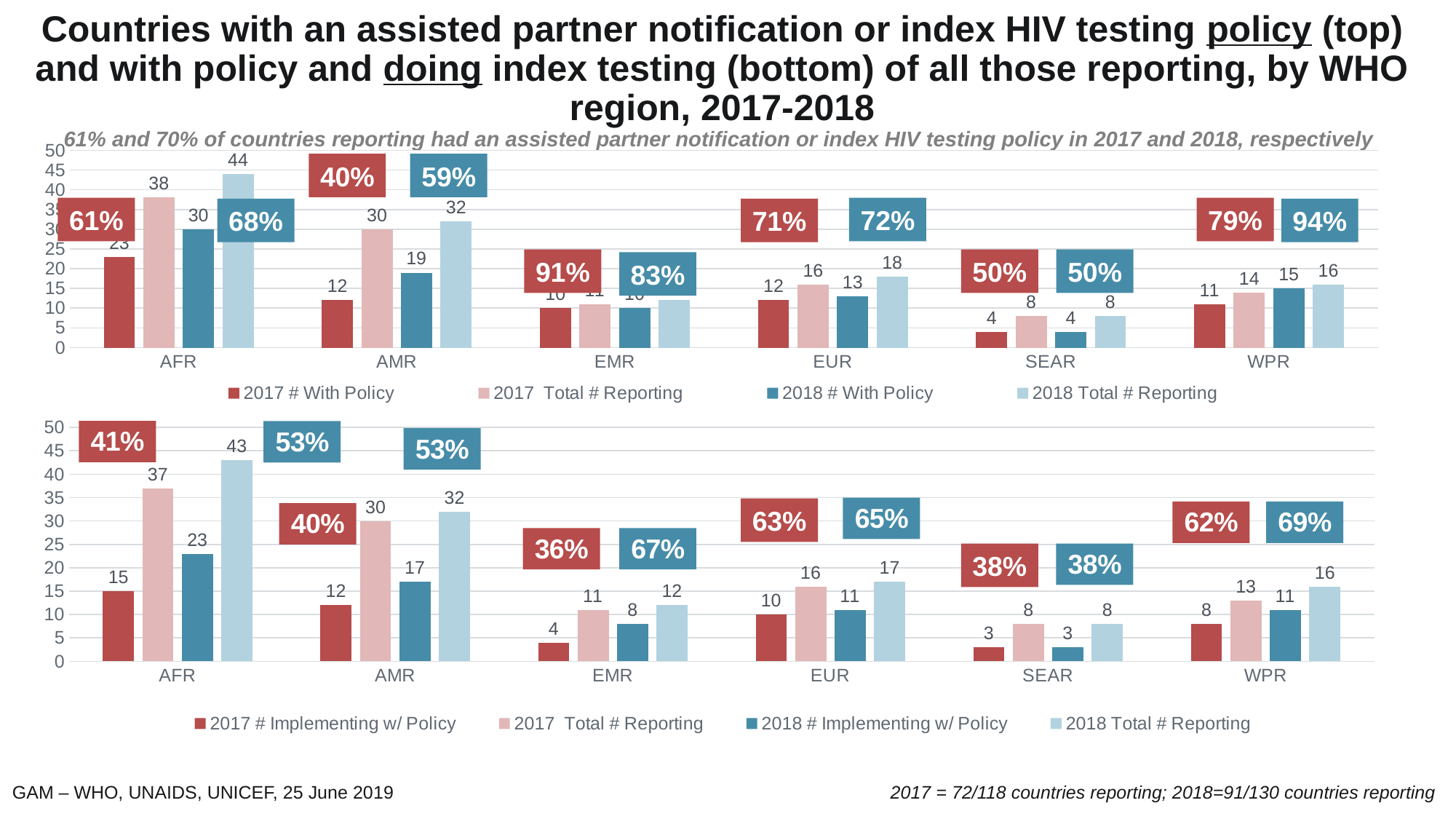
How many series does the legend of the bottom chart list? 4 In the bottom chart, what is the 2018 # Implementing w/ Policy value for EMR? 8 In the bottom chart, which region has the lowest 2017 # Implementing w/ Policy value? SEAR In the bottom chart, what is the 2017 Total # Reporting value for WPR? 13 In the top chart, which region has the highest 2018 # With Policy value? AFR In the top chart, what is the 2018 Total # Reporting value for AFR? 44 In the bottom chart, which is larger for AFR: the 2017 # Implementing w/ Policy value or the 2018 # Implementing w/ Policy value? 2018 # Implementing w/ Policy In the top chart, what is the 2017 # With Policy value for AMR? 12 In the top chart, what percentage label is shown for WPR in 2018? 94% In the top chart, what is the difference between the 2018 Total # Reporting and the 2018 # With Policy values for AMR? 13 What type of chart is the top chart? Bar chart How many regions are shown on the x axis of the top chart? 6